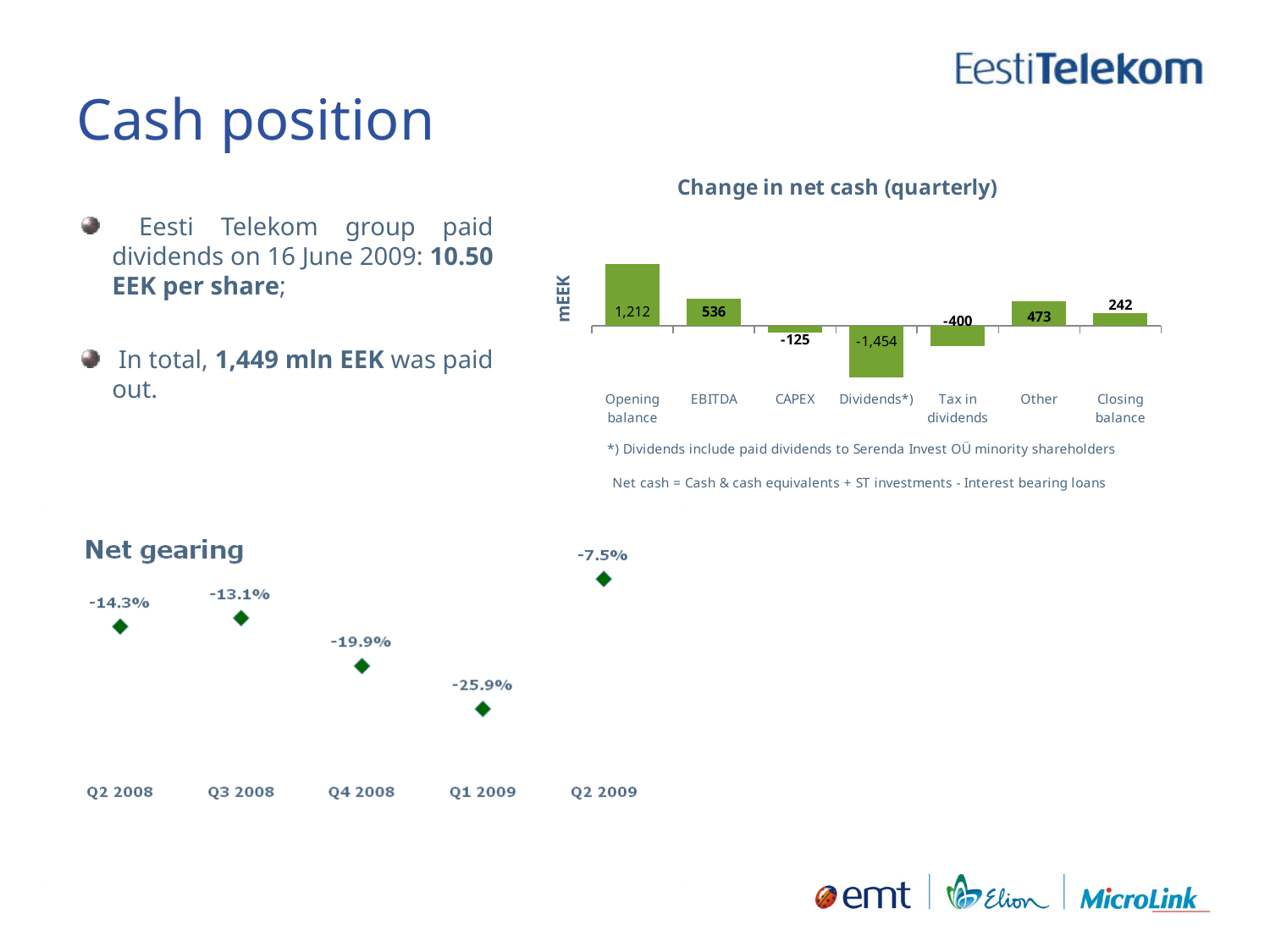
In the 'Change in net cash (quarterly)' chart, what is the value for EBITDA? 536 In the 'Net gearing' chart, how many data points are plotted? 5 In the 'Change in net cash (quarterly)' chart, how many categories are shown on the x axis? 7 In the 'Net gearing' chart, which quarter has the lowest value? Q1 2009 In the 'Change in net cash (quarterly)' chart, what is the difference between the Opening balance and the Closing balance? 970 In the 'Change in net cash (quarterly)' chart, which category has the highest value? Opening balance In the 'Net gearing' chart, what is the value for Q1 2009? -25.9% In the 'Change in net cash (quarterly)' chart, what unit is shown on the vertical axis label? mEEK In the 'Change in net cash (quarterly)' chart, which category has the lowest value? Dividends*) In the 'Change in net cash (quarterly)' chart, what is the value for Closing balance? 242 In the 'Net gearing' chart, what is the value for Q2 2009? -7.5% In the 'Change in net cash (quarterly)' chart, what is the value for Dividends*)? -1,454